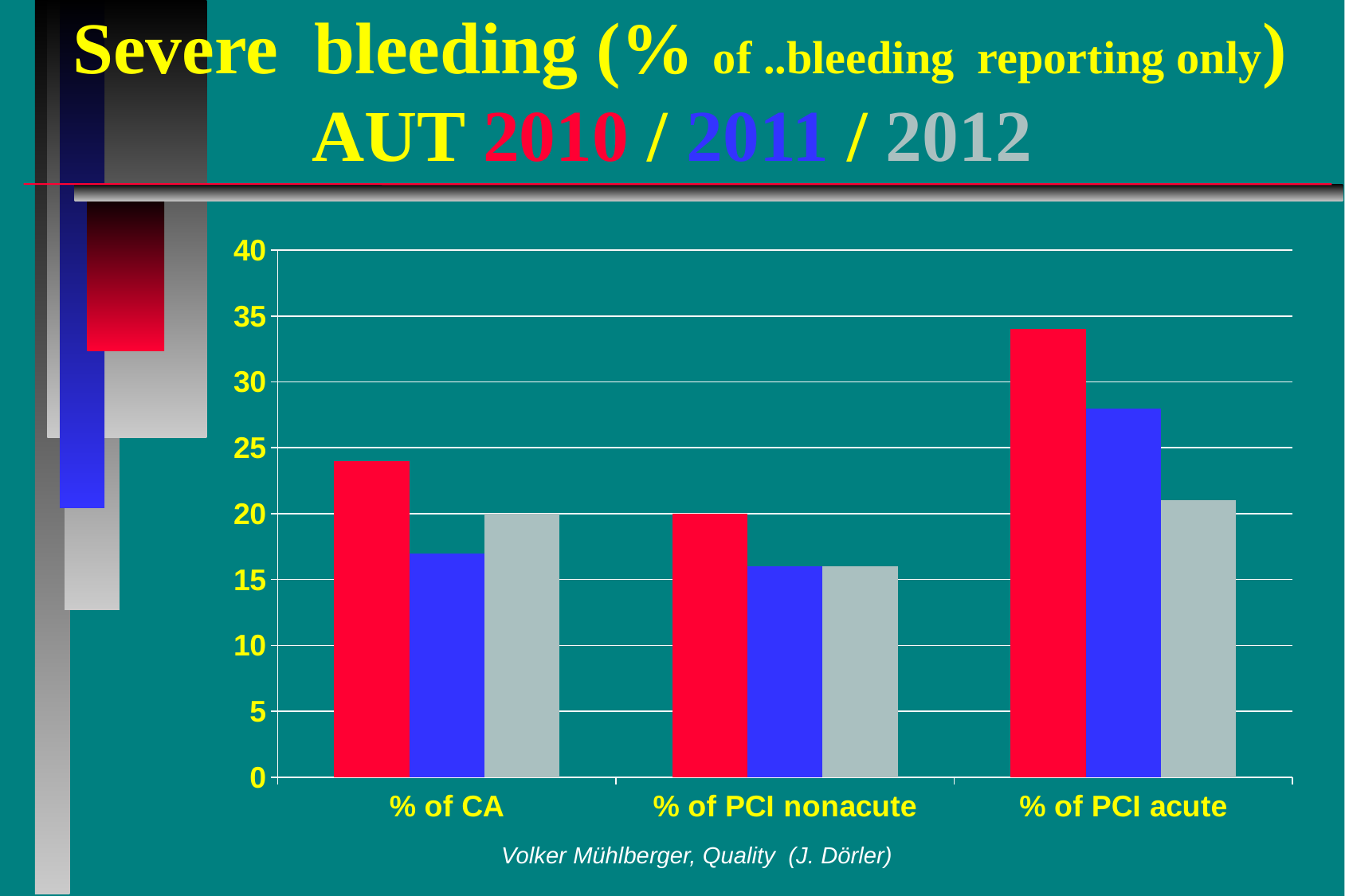
For which category is the 2010 (red) bar highest? % of PCI acute What kind of chart is shown on the slide? bar chart Is the value of the 2011 (blue) bar for % of CA greater or less than 20? less Is the value of the 2011 (blue) bar for % of PCI acute greater or less than 25? greater How many years (series) does the chart compare, according to the title? 3 What is the value of the 2012 (grey) bar for % of CA? 20 How many categories are shown on the x axis of the chart? 3 In the % of CA category, which is larger: the 2010 (red) bar or the 2011 (blue) bar? 2010 (red) Which colour represents the year 2011 in the chart? blue Is the value of the 2010 (red) bar for % of PCI acute greater or less than 30? greater What is the value of the 2010 (red) bar for % of PCI nonacute? 20